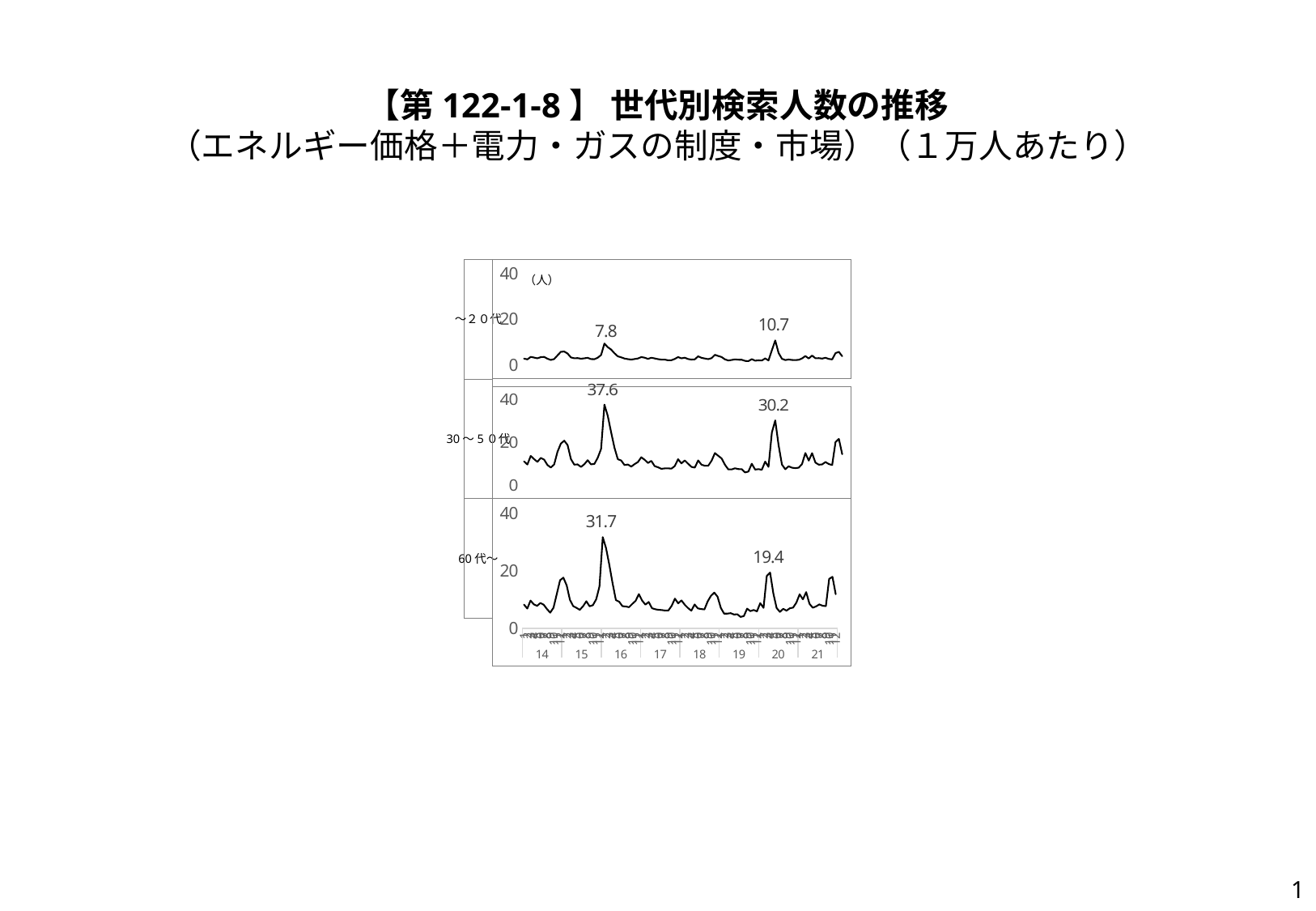
Which is larger: the 2015 peak in the middle panel (30～50代) or the 2015 peak in the bottom panel (60代～)? 30～50代 (37.6) In the bottom panel (60代～), what is the difference between the two labeled peaks, 31.7 and 19.4? 12.3 In the bottom panel (60代～), what is the value of the labeled peak around 2020? 19.4 In the middle panel (30～50代), what is the value of the highest labeled peak? 37.6 In the top panel (～20代), what is the value of the labeled peak around 2020? 10.7 In the middle panel (30～50代), what is the difference between the two labeled peaks, 37.6 and 30.2? 7.4 What unit is shown in the top-left corner of the chart area? （人） What kind of chart is used in each of the three panels on the slide? line chart In the top panel (～20代), what is the value of the labeled peak around 2015? 7.8 In the middle panel (30～50代), what is the value of the labeled peak around 2020? 30.2 In the bottom panel (60代～), what is the value of the labeled peak around 2015? 31.7 In the top panel (～20代), is the 2020 peak value greater or less than 20? less